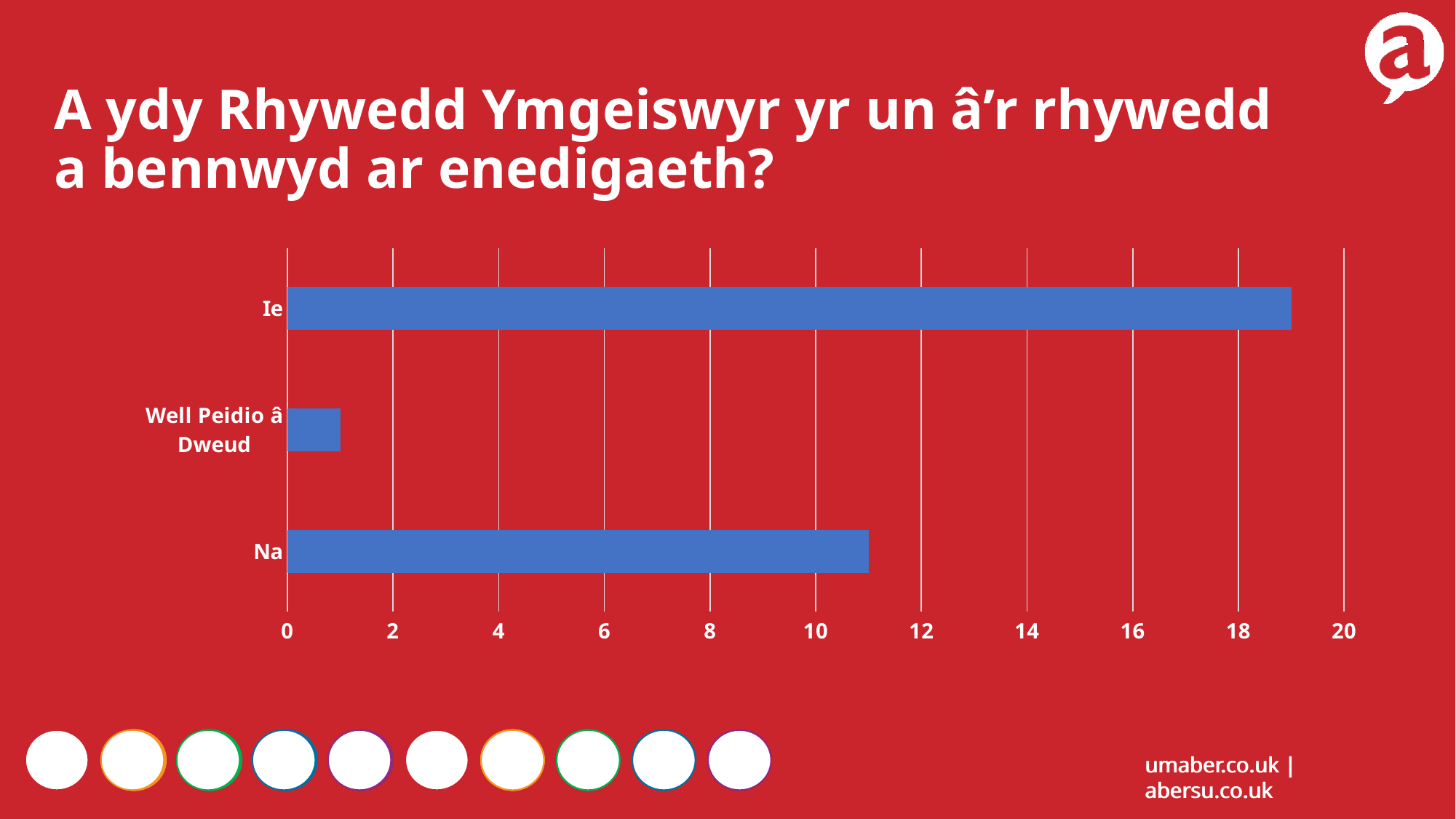
Which is larger, the value for Na or the value for Well Peidio â Dweud? Na Which category has the lowest value? Well Peidio â Dweud What kind of chart is shown on the slide? bar chart What is the highest value shown on the horizontal axis? 20 What colour are the bars in the chart? blue Which category has the highest value? Ie Which is larger, the value for Ie or the value for Na? Ie How many categories are plotted in the chart? 3 Is the value for Na greater or less than 10? greater Is the value for Ie greater or less than 18? greater Is the value for Ie greater or less than 20? less